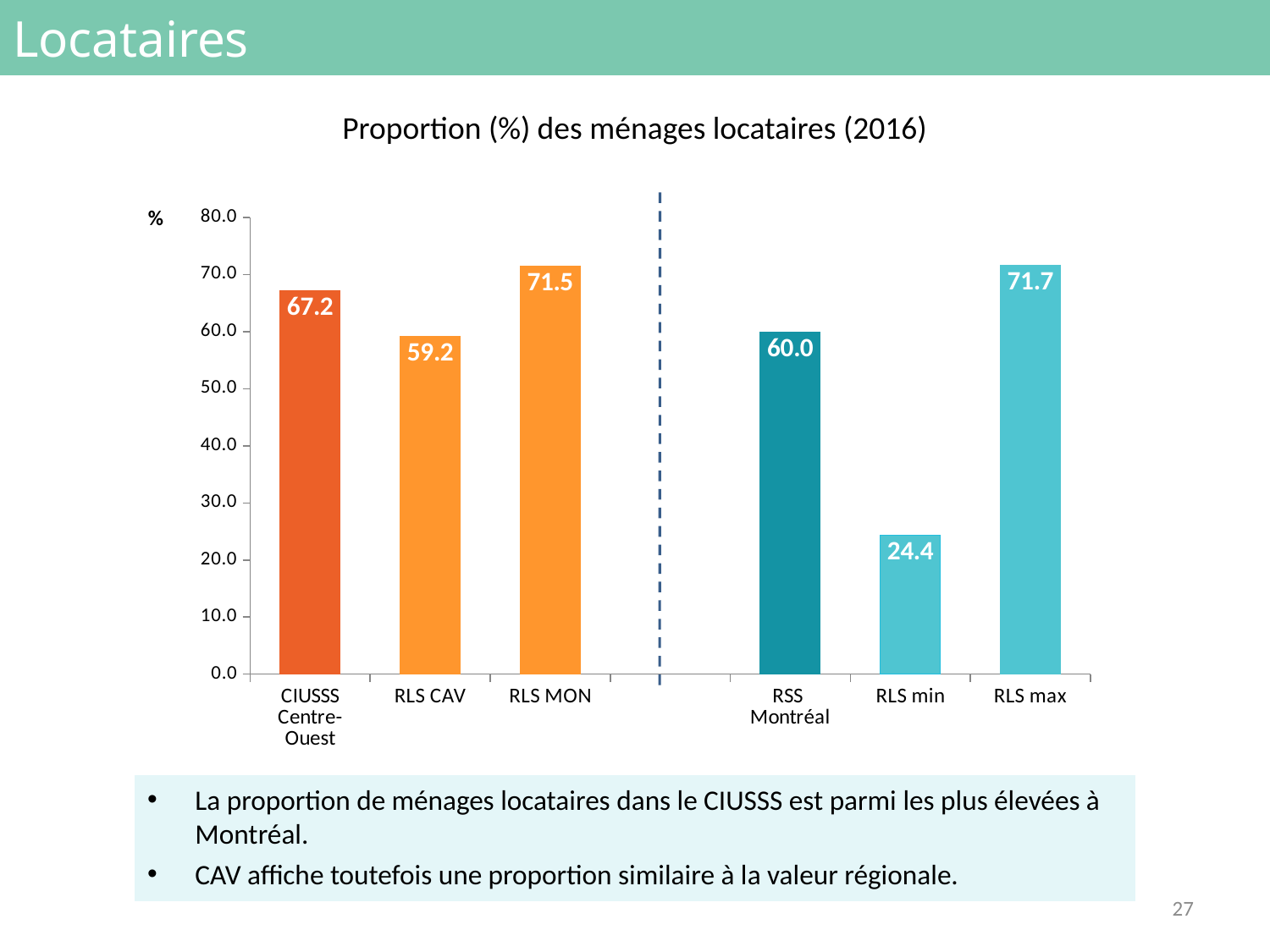
What is the value for RSS Montréal? 60.0 Which category has the lowest value? RLS min What is the value for RLS MON? 71.5 How many bars are plotted in the chart? 6 What is the difference between the values for CIUSSS Centre-Ouest and RSS Montréal? 7.2 What kind of chart is shown on the slide? bar chart What is the value for CIUSSS Centre-Ouest? 67.2 What is the value for RLS CAV? 59.2 Is the value for RLS max greater or less than 70.0? greater What is the value for RLS min? 24.4 Which is larger, the value for RLS CAV or the value for RSS Montréal? RSS Montréal What is the title of the chart? Proportion (%) des ménages locataires (2016)